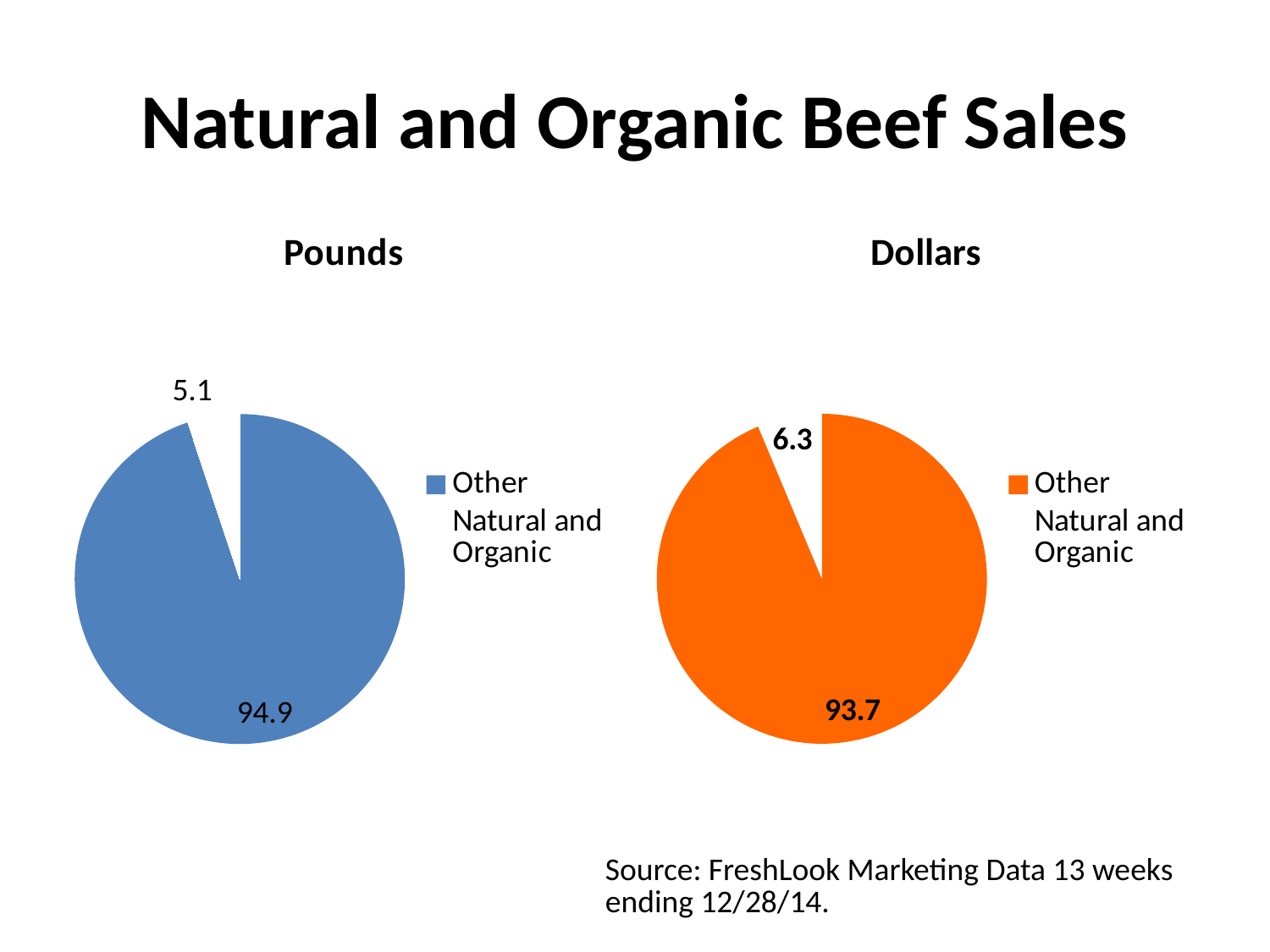
What colour is the Other slice in the "Dollars" chart? orange How many entries does the legend of the "Pounds" chart list? 2 In the "Pounds" chart, what is the difference between the Other slice and the Natural and Organic slice? 89.8 In the "Pounds" chart, which slice is the smallest? Natural and Organic Is the Natural and Organic value larger in the "Pounds" chart or the "Dollars" chart? Dollars In the "Pounds" chart, what is the value for Other? 94.9 In the "Dollars" chart, what is the value for Natural and Organic? 6.3 How many slices does the "Dollars" chart have? 2 In the "Pounds" chart, what is the value for Natural and Organic? 5.1 In the "Dollars" chart, which slice is the largest? Other In the "Dollars" chart, what is the value for Other? 93.7 What kind of chart is the "Pounds" chart? pie chart